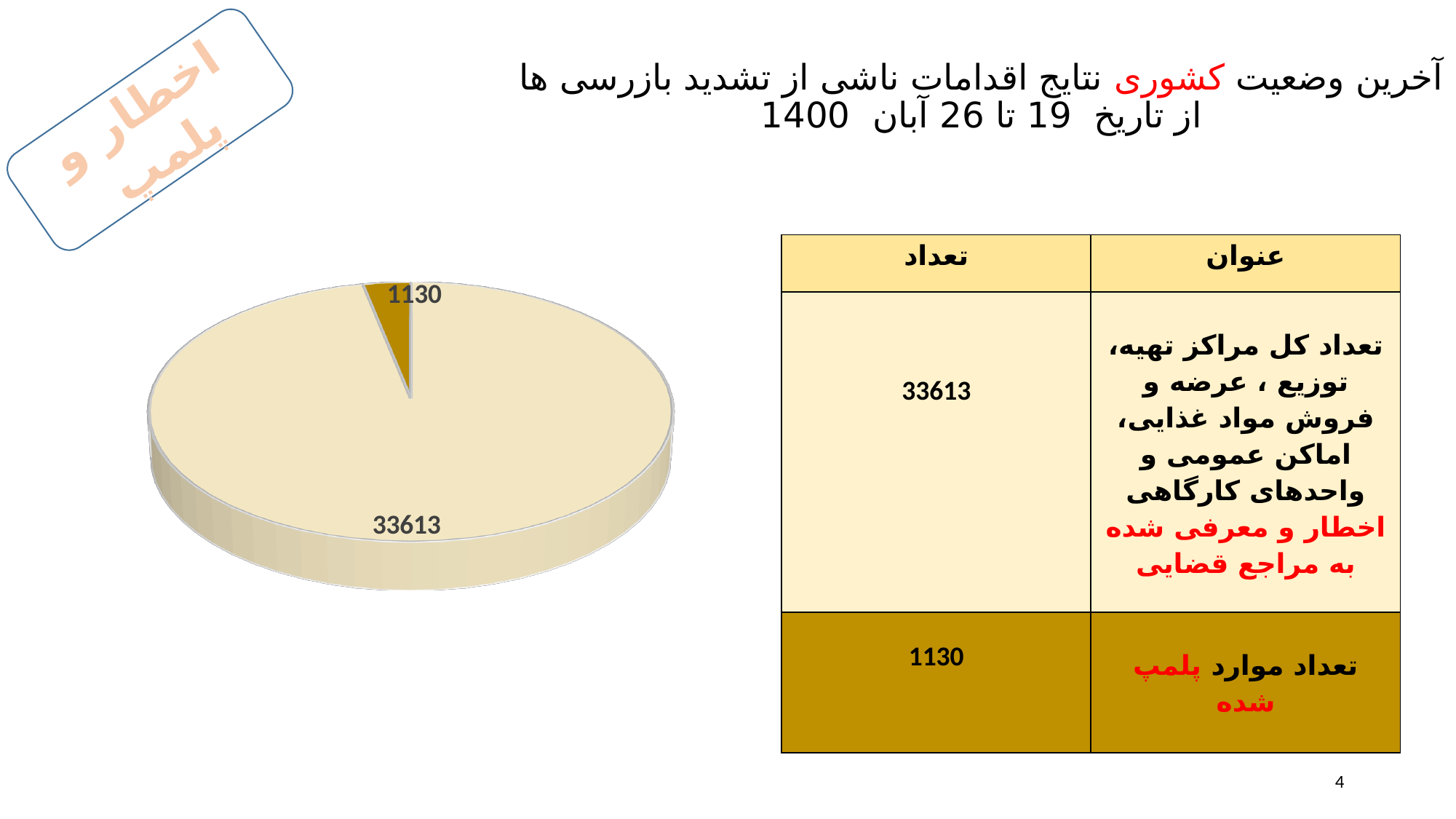
Which is larger: the number of sealed cases or the number of centres warned and referred to judicial authorities? Centres warned and referred to judicial authorities (33613) What kind of chart is shown on the left of the slide? Pie chart What value is labelled on the large light-beige slice of the pie chart? 33613 What is the total of the two values shown in the pie chart? 34743 What is the difference between the two values shown in the pie chart, 33613 and 1130? 32483 How many slices does the pie chart have? 2 What colour is the slice representing the sealed cases (1130) in the pie chart? Dark gold According to the table, what is the value for the centres warned and referred to judicial authorities (اخطار و معرفی شده به مراجع قضایی)? 33613 What value is labelled on the small dark-gold slice of the pie chart? 1130 Which slice of the pie chart is the smallest? 1130 (sealed cases) According to the table, what is the value for the sealed cases (تعداد موارد پلمپ شده)? 1130 Which slice of the pie chart is the largest? 33613 (warned and referred to judicial authorities)